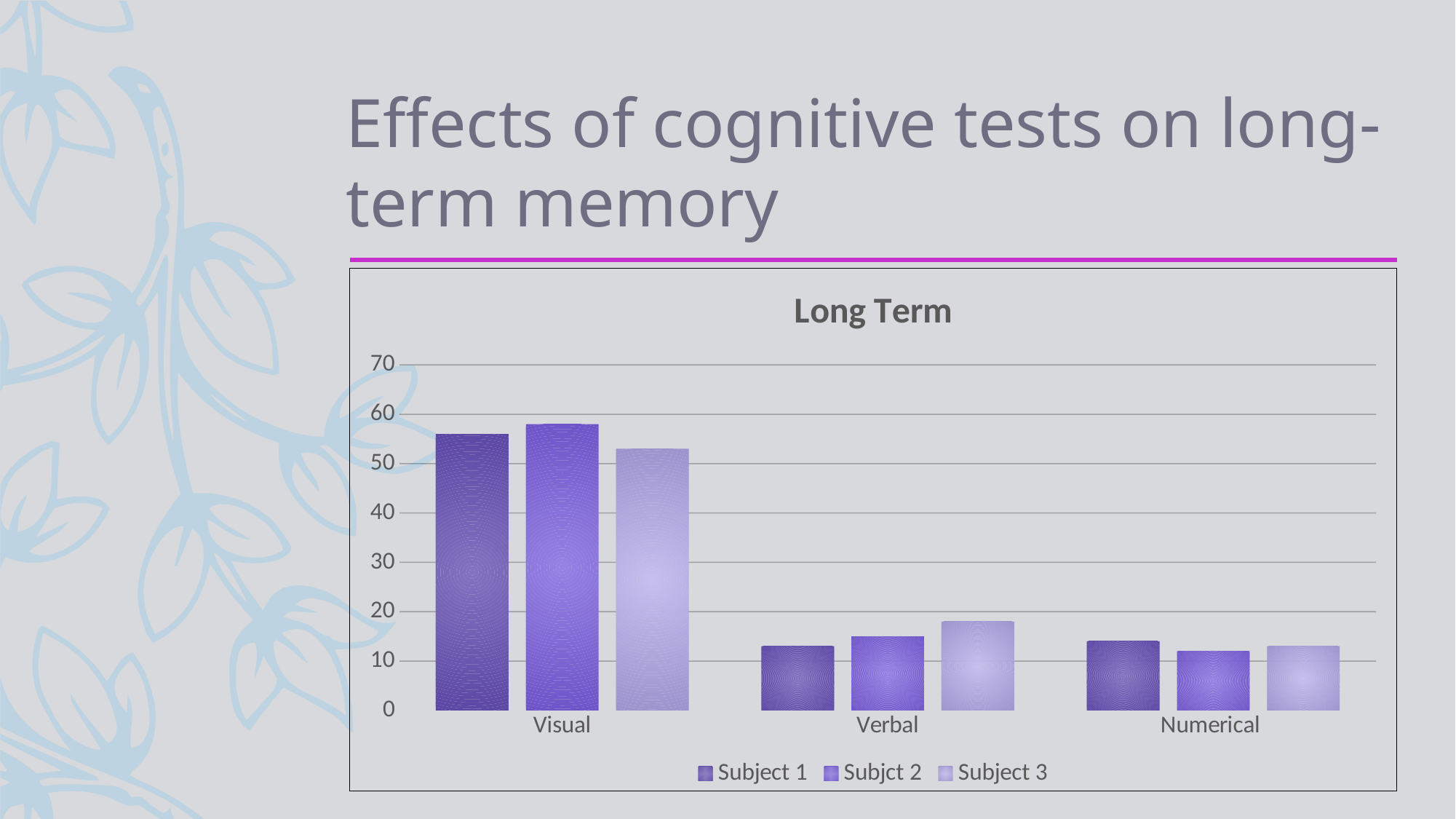
Do the values for Subject 3 rise or fall from Visual to Numerical along the x axis? fall Which is larger: Subject 3 in the Verbal category or Subject 1 in the Verbal category? Subject 3 in the Verbal category How many series does the legend list? 3 Is the value for Subject 1 in the Visual category greater or less than 50? greater How many categories are shown on the x axis? 3 Is the value for Subjct 2 in the Visual category greater or less than 60? less Is the value for Subject 3 in the Verbal category greater or less than 20? less What kind of chart is shown on the slide? bar chart Which series has the tallest bar in the Verbal category? Subject 3 What is the title of the chart? Long Term Which is larger: Subject 1 in the Visual category or Subject 1 in the Numerical category? Subject 1 in the Visual category Which category has the highest values across all subjects? Visual